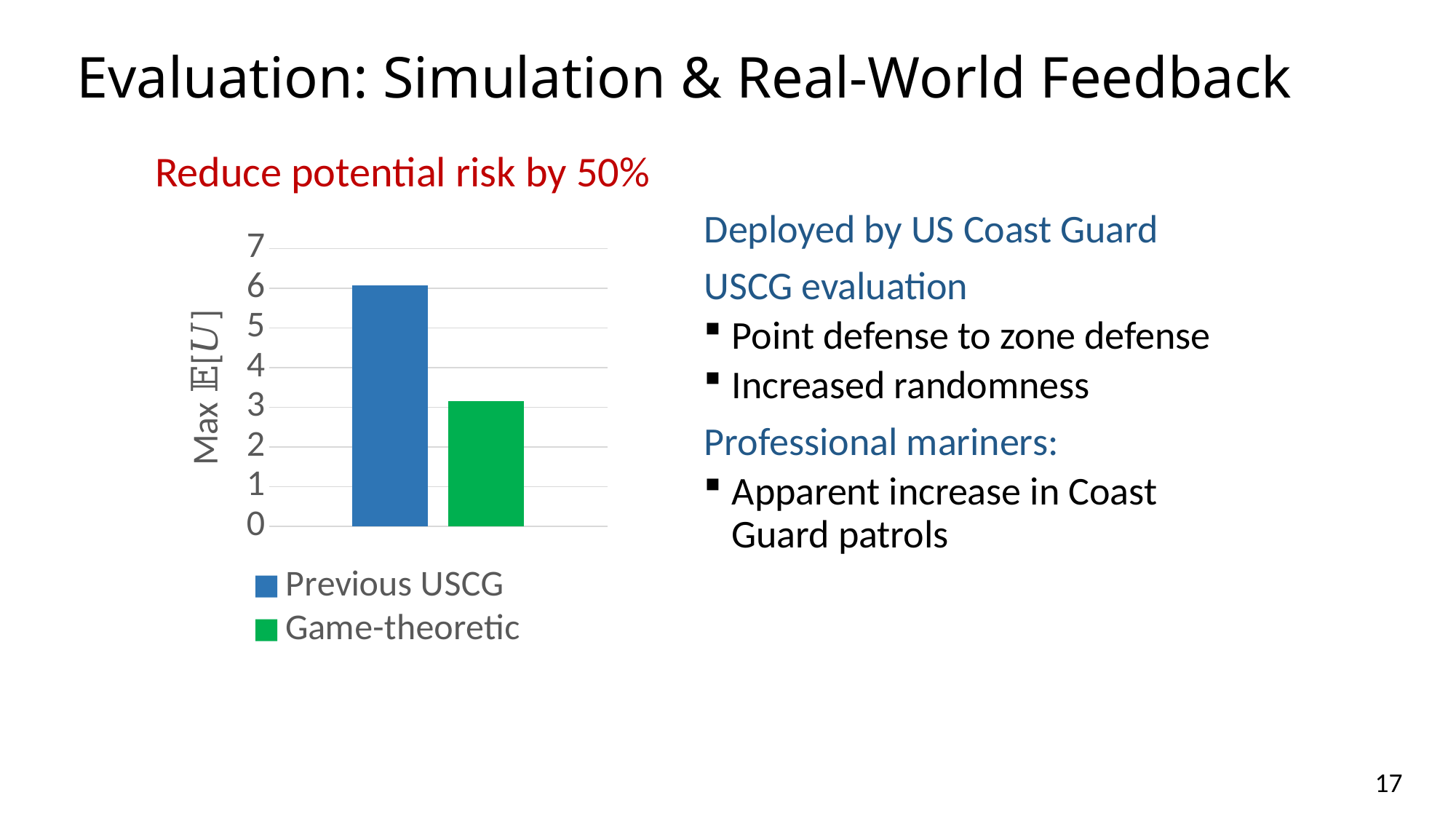
What is the label on the vertical axis of the chart? Max E[U] Which is larger, the value for Previous USCG or the value for Game-theoretic? Previous USCG How many series does the chart legend list? 2 Is the value for Game-theoretic greater or less than 4? less What kind of chart is shown on the slide? bar chart Which series has the highest bar in the chart? Previous USCG Which series has the lowest bar in the chart? Game-theoretic What colour is the bar for Game-theoretic in the chart? green How many bars are plotted in the chart? 2 Is the value for Game-theoretic greater or less than 2? greater Is the value for Previous USCG greater or less than 5? greater